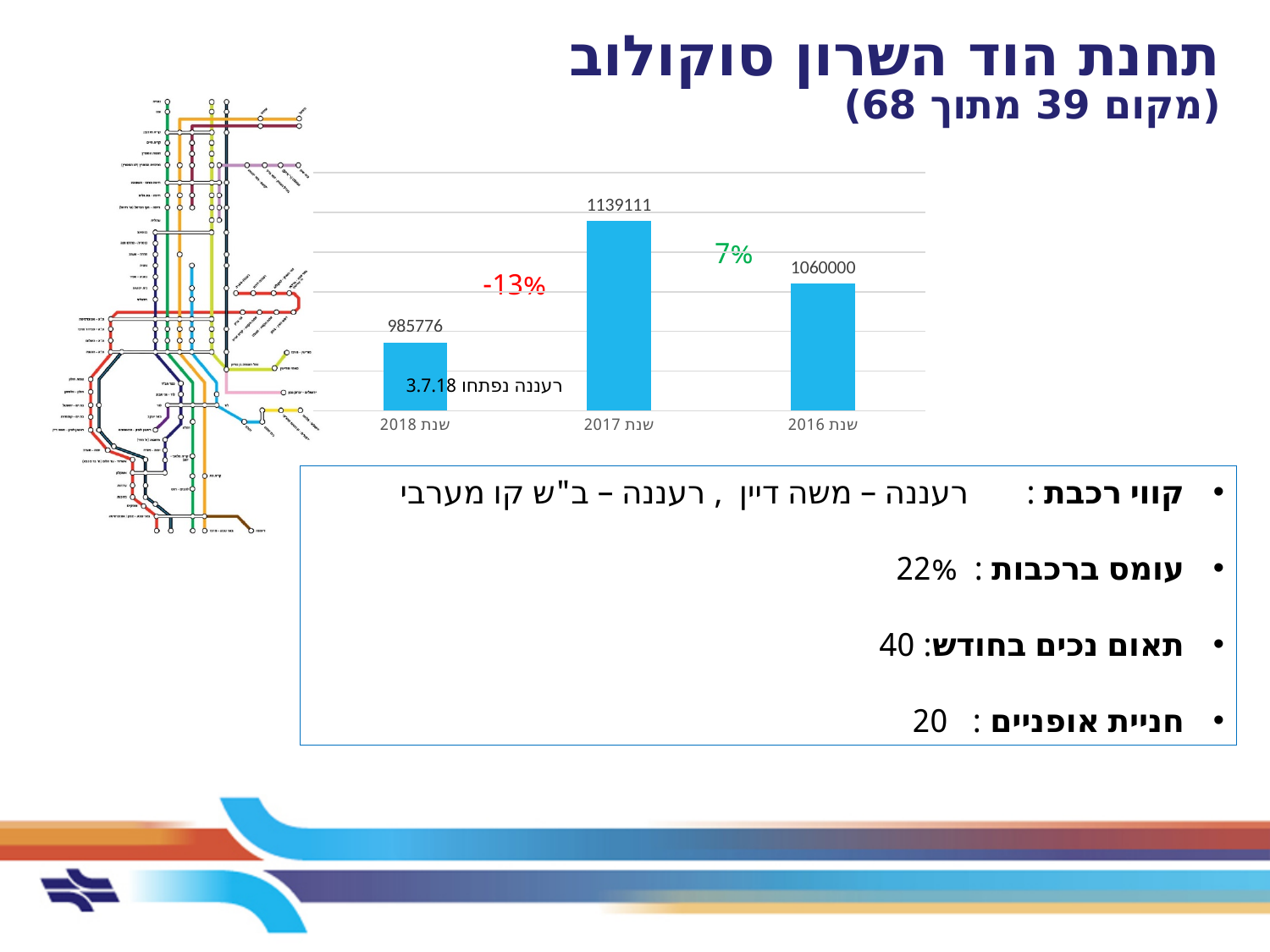
Which is larger, the value for שנת 2016 or the value for שנת 2018? שנת 2016 What is the difference between the values for שנת 2017 and שנת 2016? 79111 Which year has the lowest bar? שנת 2018 What kind of chart is shown on the slide? bar chart What percentage change is annotated in green between שנת 2017 and שנת 2016? 7% What percentage change is annotated in red between שנת 2018 and שנת 2017? -13% What is the value shown for שנת 2018? 985776 Which year has the highest bar? שנת 2017 What is the value shown for שנת 2016? 1060000 How many bars are in the chart? 3 What is the value shown for שנת 2017? 1139111 What is the difference between the values for שנת 2017 and שנת 2018? 153335